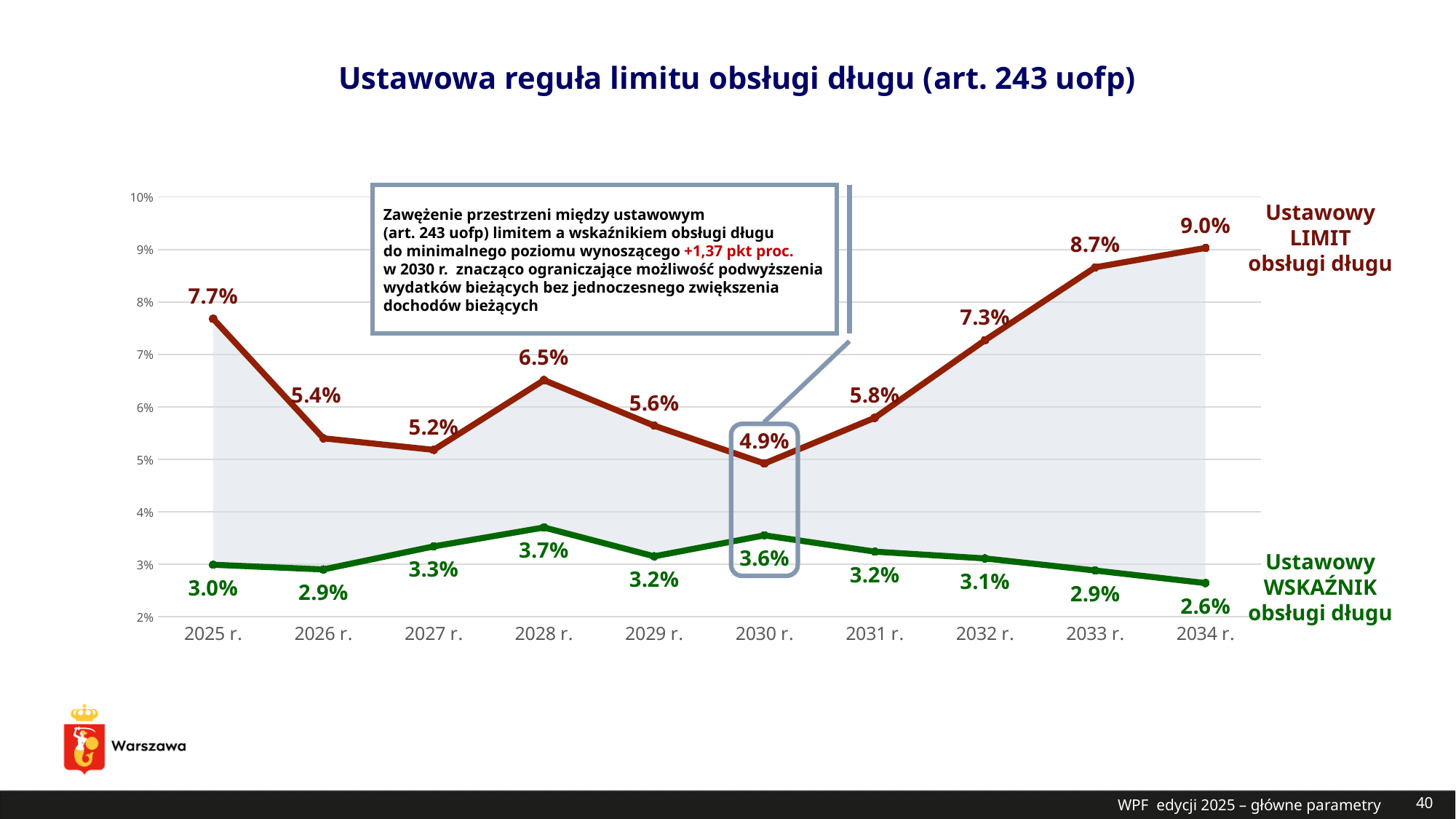
What is the value of the Ustawowy WSKAŹNIK obsługi długu series for 2028 r.? 3.7% What is the difference between the Ustawowy LIMIT obsługi długu and the Ustawowy WSKAŹNIK obsługi długu in 2034 r.? 6.4 percentage points How many data series are plotted on the chart? 2 In which year does the Ustawowy LIMIT obsługi długu series reach its lowest value? 2030 r. What is the value of the Ustawowy LIMIT obsługi długu series for 2030 r.? 4.9% How many years are shown on the x axis of the chart? 10 Which is larger for the Ustawowy LIMIT obsługi długu series: the value for 2026 r. or the value for 2028 r.? 2028 r. Does the Ustawowy LIMIT obsługi długu series rise or fall from 2030 r. to 2034 r.? Rise What type of chart is shown on the slide? Line chart In which year does the Ustawowy LIMIT obsługi długu series reach its highest value? 2034 r. In which year is the Ustawowy WSKAŹNIK obsługi długu series lowest? 2034 r. What is the value of the Ustawowy LIMIT obsługi długu series for 2025 r.? 7.7%